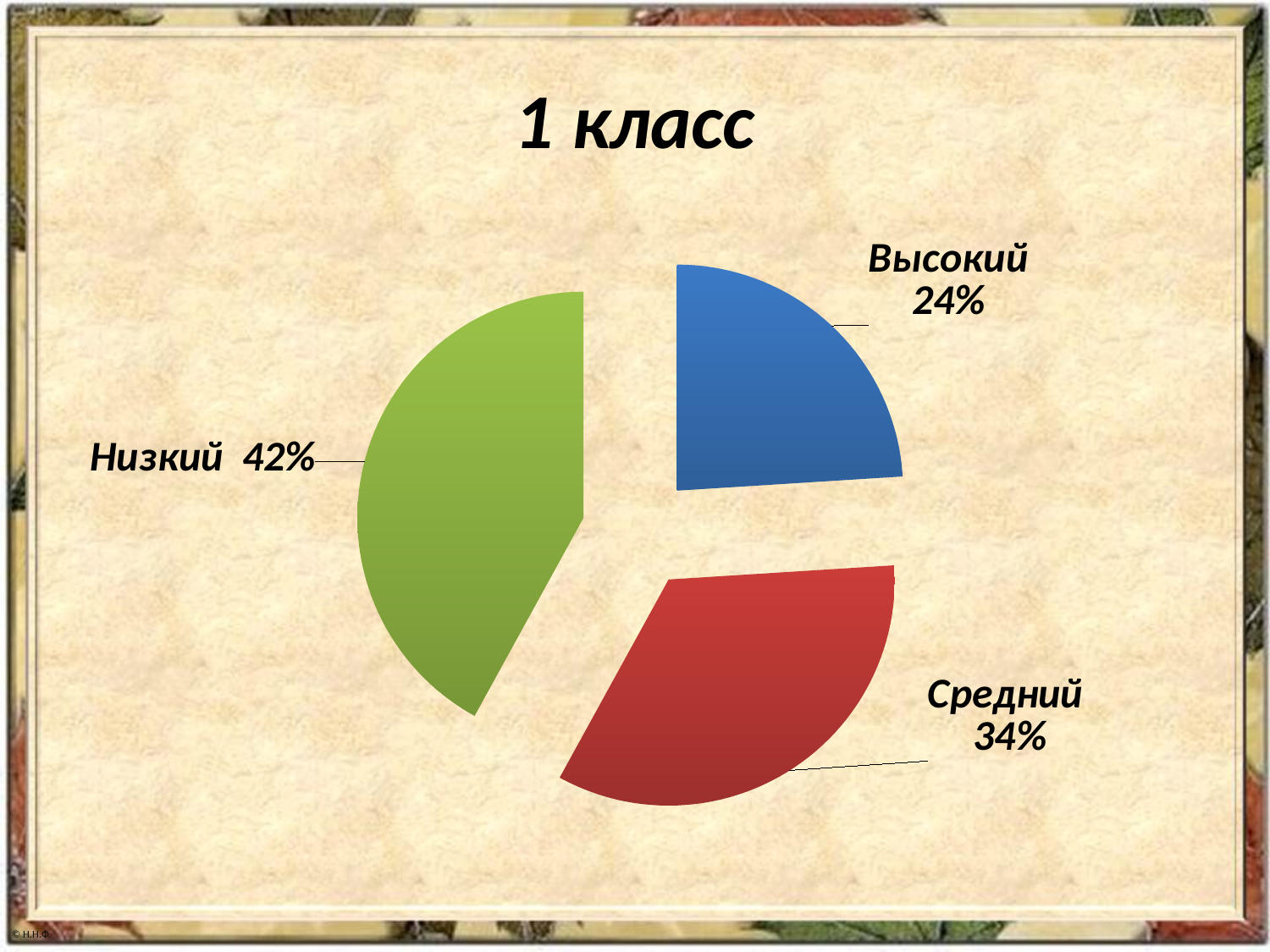
Which is larger, the Средний slice or the Высокий slice? Средний Which category has the largest slice of the pie? Низкий Which category has the smallest slice of the pie? Высокий What kind of chart is shown on the slide? pie chart What is the title of the chart? 1 класс What is the difference in percentage points between the Низкий and Высокий slices? 18% What share of the pie does the Высокий slice represent? 24% What share of the pie does the Средний slice represent? 34% What is the difference in percentage points between the Средний and Высокий slices? 10% What share of the pie does the Низкий slice represent? 42% What colour is the Низкий slice? green How many slices does the pie chart have? 3